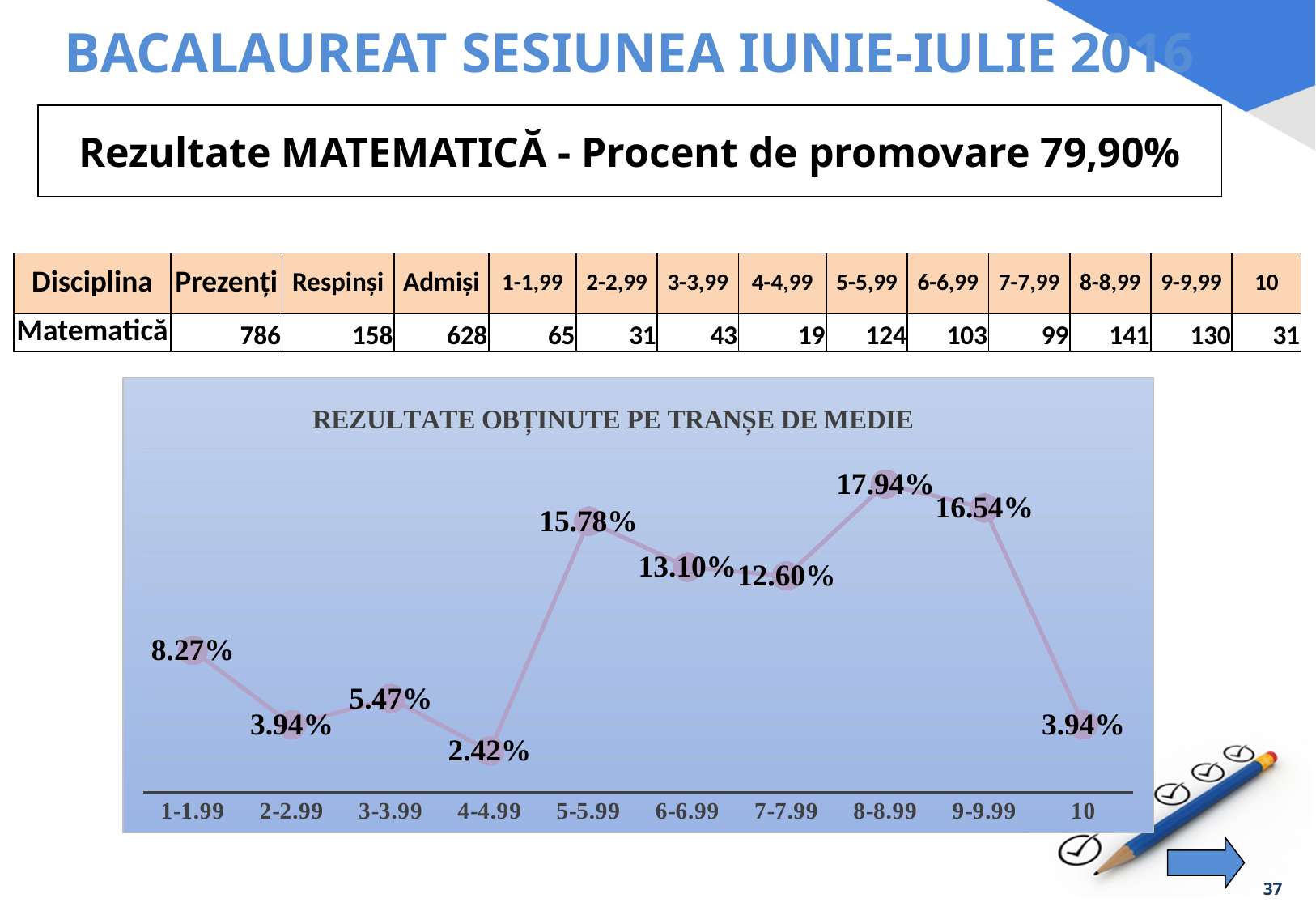
Which is larger, the value for 6-6.99 or the value for 7-7.99? 6-6.99 What is the value for the 5-5.99 category? 15.78% What type of chart is shown on the slide? line chart How many categories are plotted on the x axis? 10 What is the title of the chart? REZULTATE OBȚINUTE PE TRANȘE DE MEDIE Which category has the highest value? 8-8.99 What is the difference between the values for 8-8.99 and 9-9.99? 1.40% What is the value for the 9-9.99 category? 16.54% What is the value for the 10 category? 3.94% Which category has the lowest value? 4-4.99 Do the values rise or fall from 4-4.99 to 5-5.99? rise What is the value for the 1-1.99 category? 8.27%